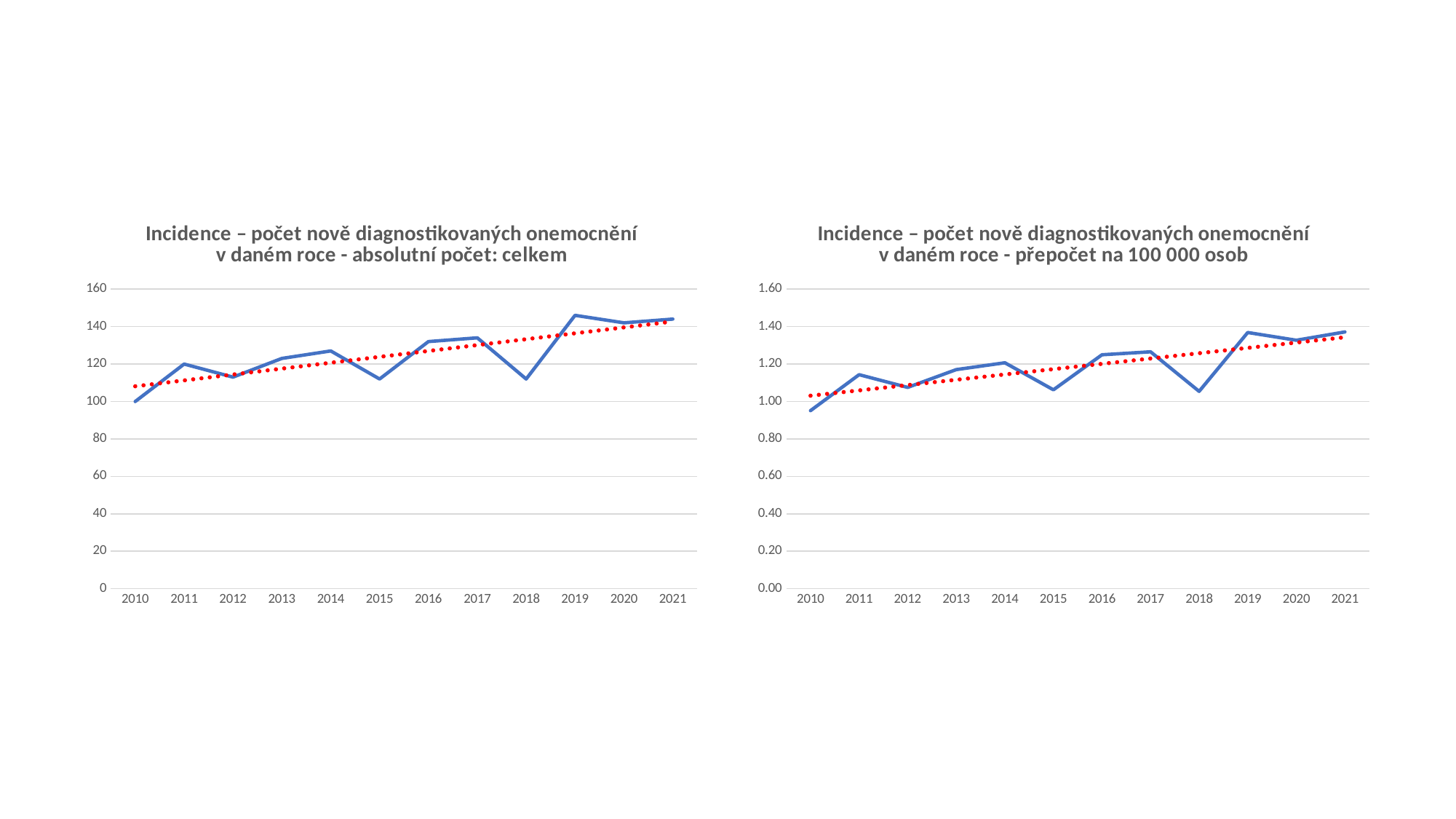
In the right chart (přepočet na 100 000 osob), which year has the lowest value? 2010 In the left chart (absolutní počet: celkem), which year has the highest value? 2019 In the right chart (přepočet na 100 000 osob), is the value for 2010 greater or less than 1.00? less In the right chart (přepočet na 100 000 osob), what is the highest value shown on the y axis? 1.60 What type of chart is the left chart, 'absolutní počet: celkem'? line chart In the right chart (přepočet na 100 000 osob), which year has the larger value, 2014 or 2015? 2014 In the left chart (absolutní počet: celkem), which year has the lowest value? 2010 In the left chart (absolutní počet: celkem), how many years are shown on the x axis? 12 In the left chart (absolutní počet: celkem), which year has the larger value, 2018 or 2019? 2019 In the left chart (absolutní počet: celkem), is the value for 2018 greater or less than 120? less In the left chart (absolutní počet: celkem), is the value for 2019 greater or less than 140? greater In the left chart (absolutní počet: celkem), what is the overall direction of the dotted trend line from 2010 to 2021? rising